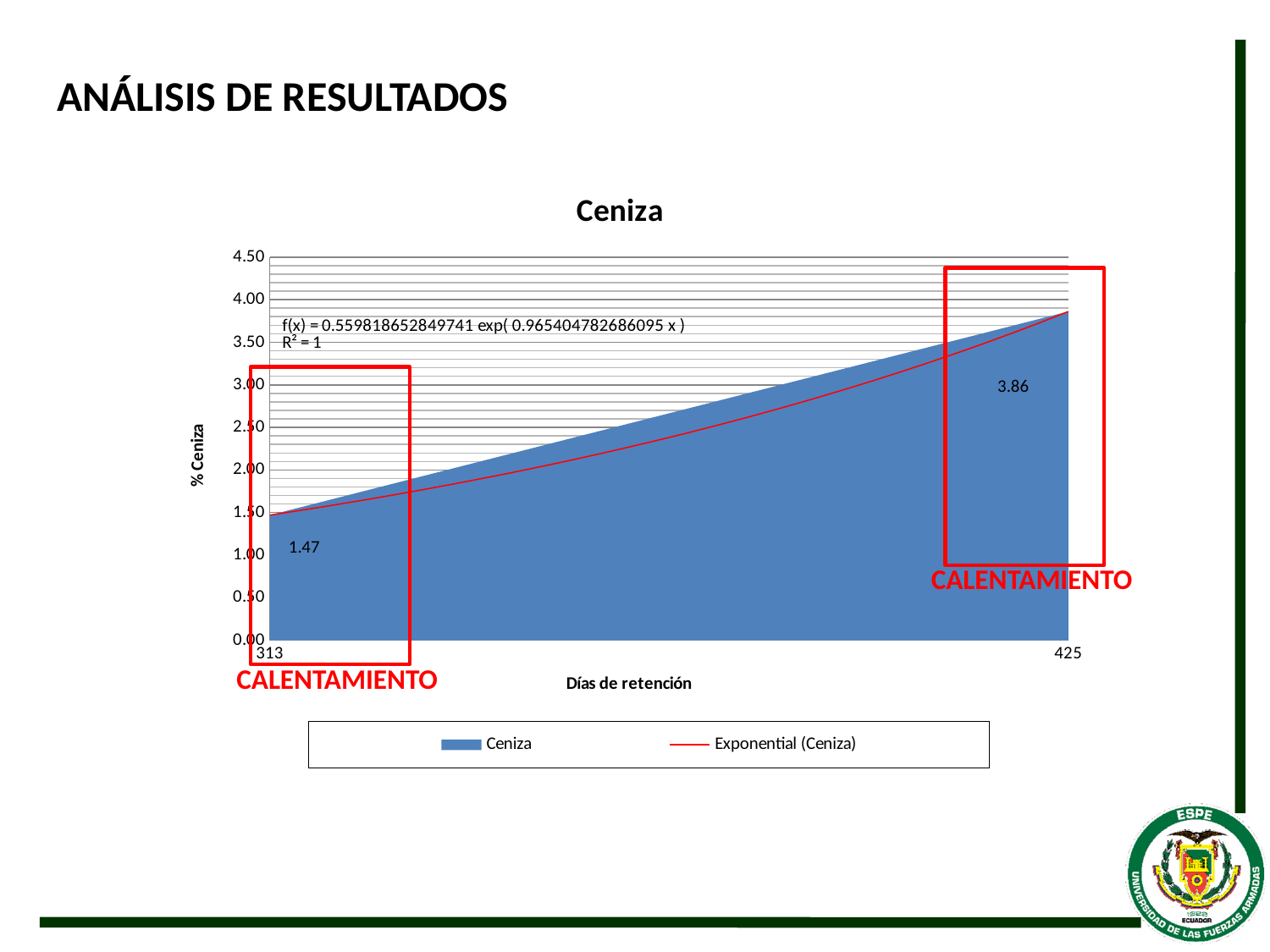
Which is larger, the % Ceniza value at 313 or at 425 días de retención? 425 How many entries does the legend list? 2 What is the title of the chart? Ceniza What is the % Ceniza value at 425 días de retención? 3.86 Which x-axis category has the highest % Ceniza value? 425 How many data points are plotted for the Ceniza series? 2 What is the label of the x axis? Días de retención What is the % Ceniza value at 313 días de retención? 1.47 What is the difference between the % Ceniza values at 425 and 313 días de retención? 2.39 Does the % Ceniza value rise or fall from 313 to 425 días de retención? rise Is the % Ceniza value at 425 días de retención greater or less than 3.50? greater Which x-axis category has the lowest % Ceniza value? 313